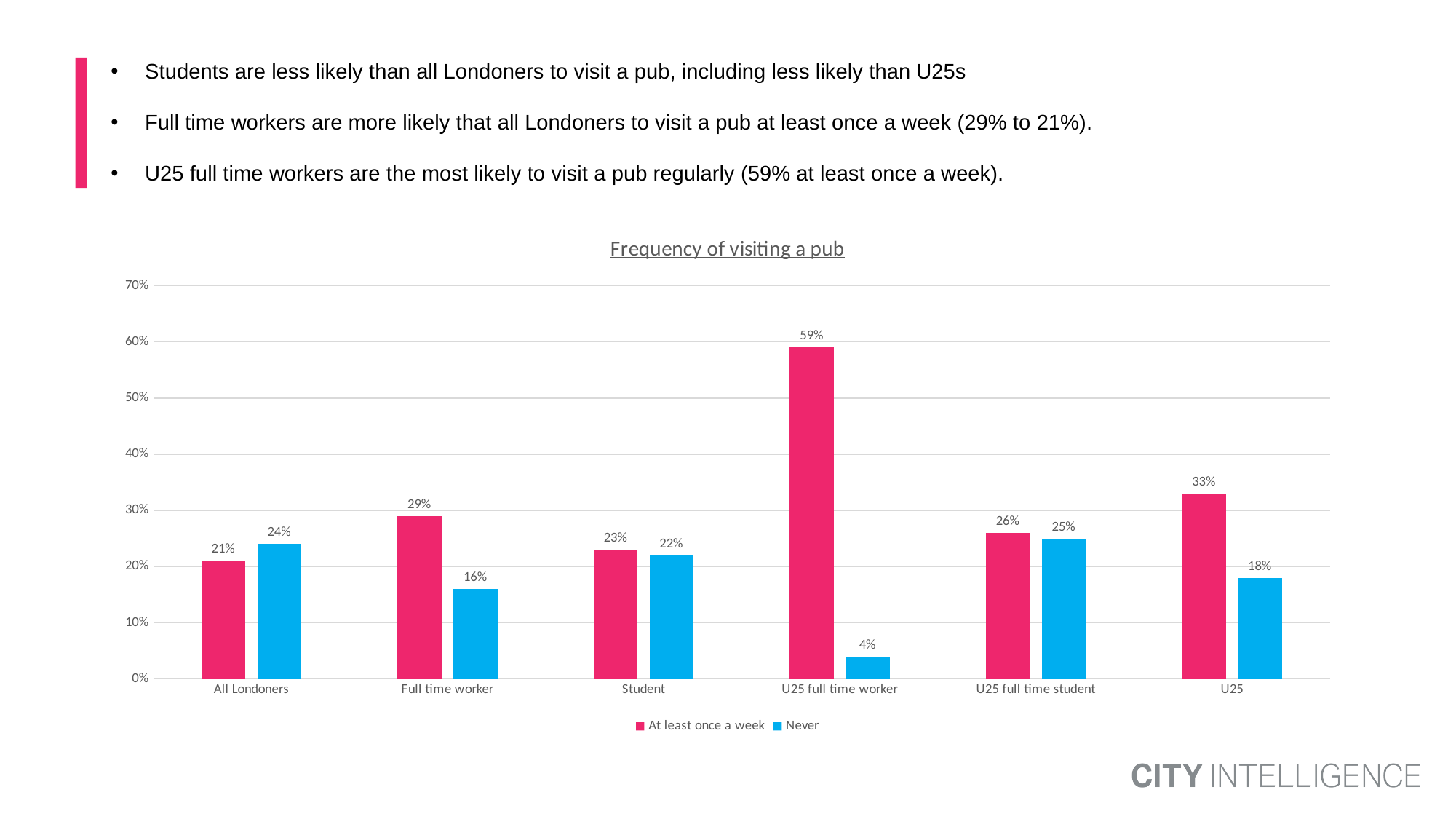
Is the 'At least once a week' value for U25 greater or less than 30%? greater What kind of chart is shown? Bar chart How many categories are shown on the x axis? 6 What is the title of the chart? Frequency of visiting a pub Which is larger for Student: 'At least once a week' or 'Never'? At least once a week Which category has the lowest 'Never' value? U25 full time worker How many series does the legend list? 2 What is the 'Never' value for Full time worker? 16% What is the 'Never' value for U25? 18% What is the difference between the 'At least once a week' values for Full time worker and All Londoners? 8% What is the 'At least once a week' value for U25 full time worker? 59% Which category has the highest 'At least once a week' value? U25 full time worker